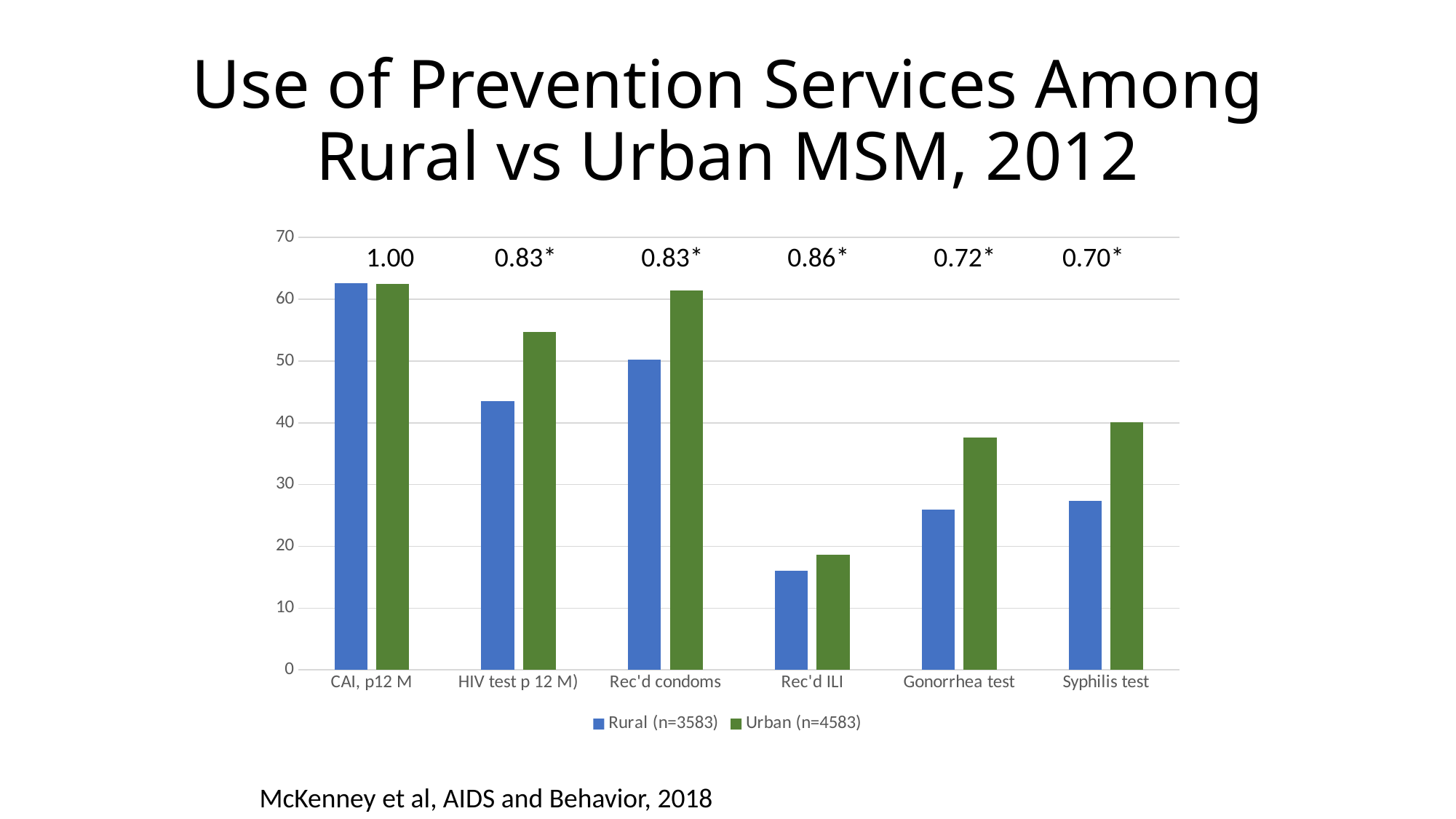
What value is printed above the Syphilis test bars? 0.70* Which category has the lowest value for Rural (n=3583)? Rec'd ILI Is the Rural (n=3583) value for HIV test p 12 M) greater or less than 40? greater Which category has the lowest value for Urban (n=4583)? Rec'd ILI Is the Urban (n=4583) value for Gonorrhea test greater or less than 40? less Is the Rural (n=3583) value for Gonorrhea test greater or less than 30? less For HIV test p 12 M), which is larger: Rural (n=3583) or Urban (n=4583)? Urban (n=4583) What type of chart is shown on the slide? bar chart For Syphilis test, which is larger: Rural (n=3583) or Urban (n=4583)? Urban (n=4583) How many prevention service categories are shown on the x axis? 6 Which category has the highest value for Rural (n=3583)? CAI, p12 M How many series does the legend list? 2